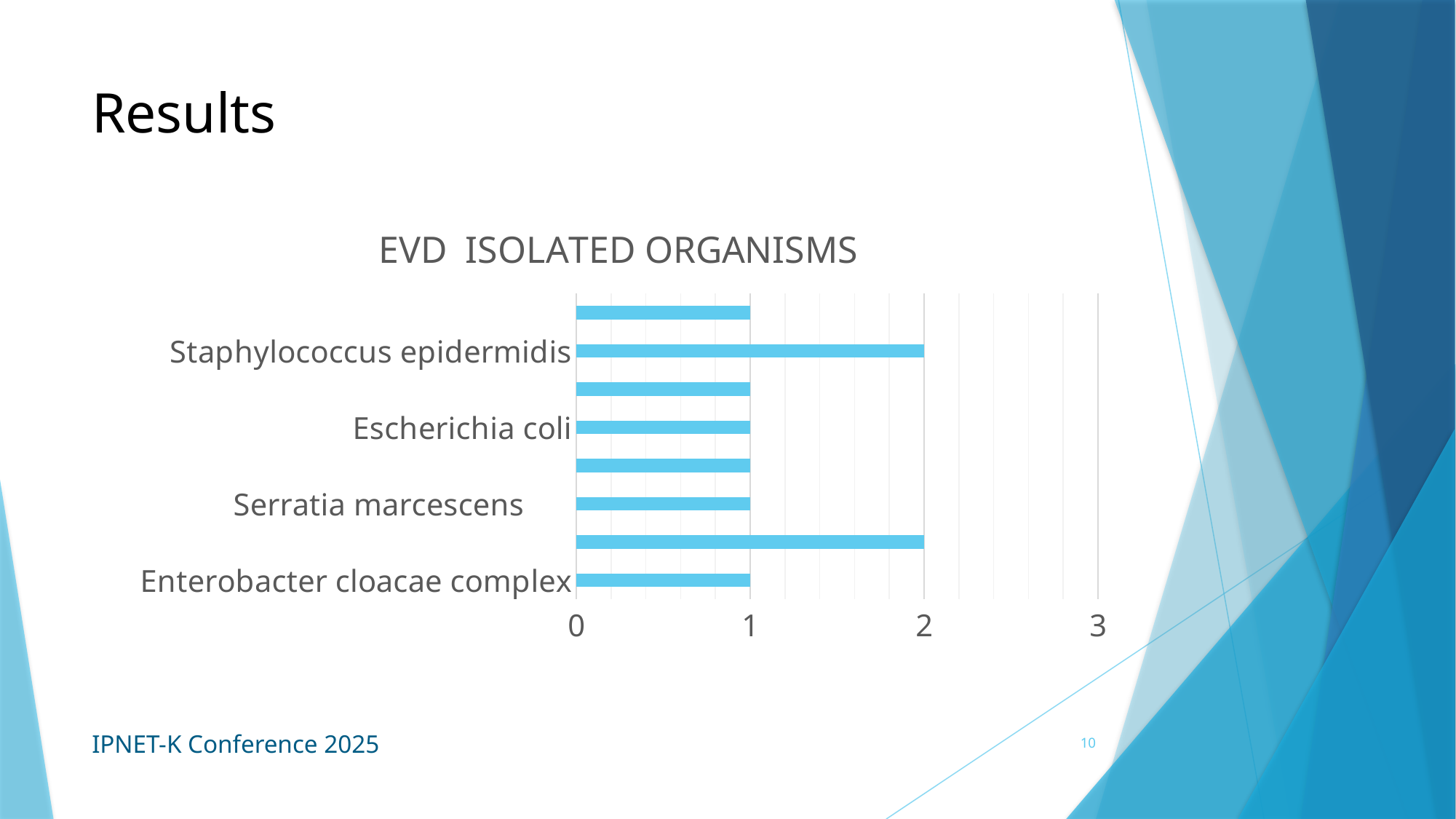
Which is larger, the value for Staphylococcus epidermidis or the value for Escherichia coli? Staphylococcus epidermidis What type of chart is shown on the slide? Bar chart What is the value for Staphylococcus epidermidis? 2 What is the value for Serratia marcescens? 1 What is the highest value shown on the horizontal axis? 3 How many bars are plotted in the chart? 8 What is the difference between the value for Staphylococcus epidermidis and the value for Serratia marcescens? 1 What is the title of the chart? EVD ISOLATED ORGANISMS What is the value for Escherichia coli? 1 What is the value for Enterobacter cloacae complex? 1 Is the value for Enterobacter cloacae complex greater or less than 2? less Which of the labeled organisms has the highest value? Staphylococcus epidermidis